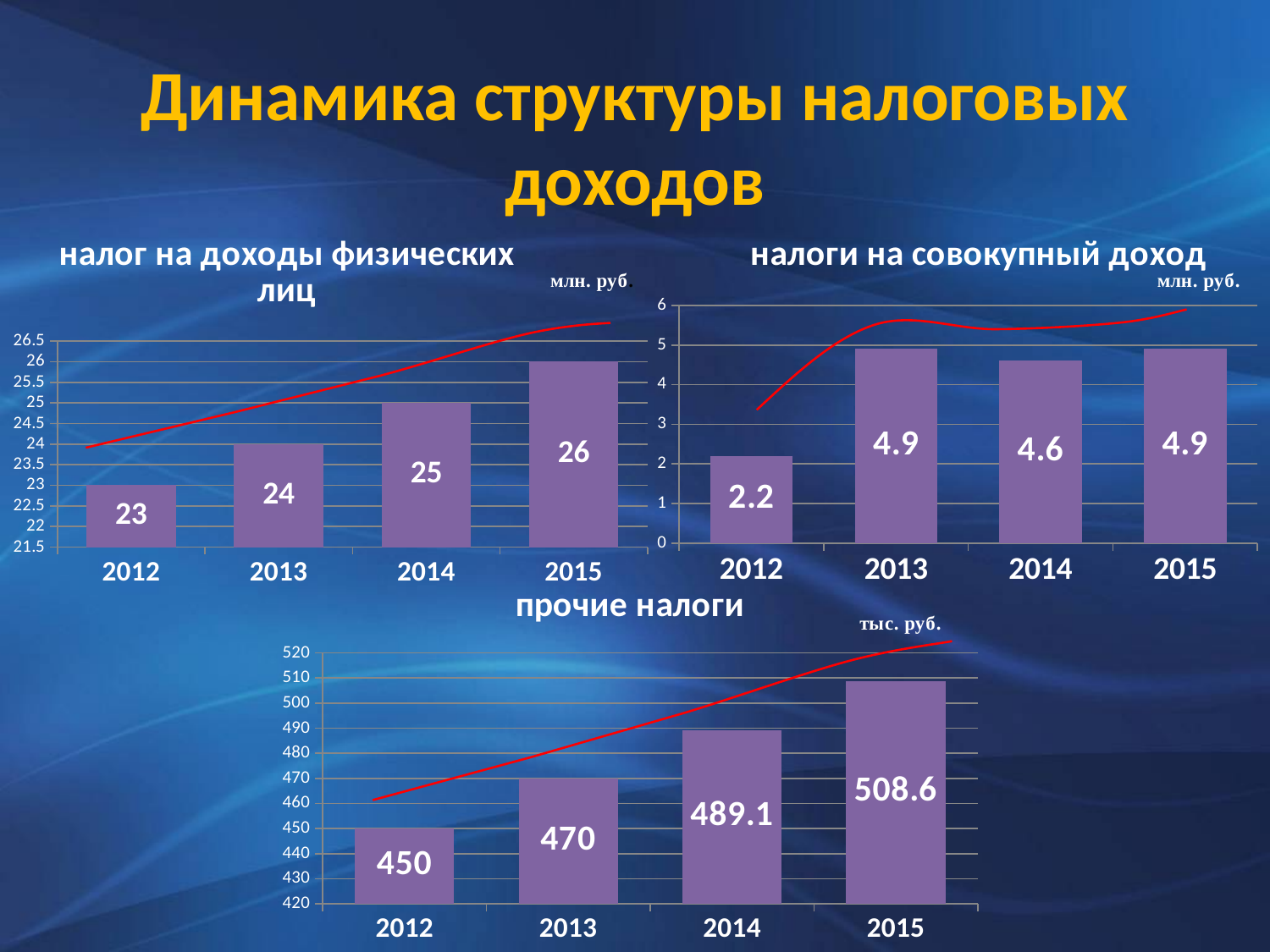
In the chart 'прочие налоги', what is the difference between the values for 2014 and 2013? 19.1 In the chart 'налог на доходы физических лиц', what is the difference between the values for 2015 and 2012? 3 In the chart 'налог на доходы физических лиц', which year has the lowest value? 2012 In the chart 'налоги на совокупный доход', what is the value for 2014? 4.6 In the chart 'налоги на совокупный доход', which is larger, the value for 2013 or the value for 2014? 2013 In the chart 'прочие налоги', what is the value for 2015? 508.6 In the chart 'прочие налоги', which year has the highest value? 2015 In the chart 'налоги на совокупный доход', what is the value for 2012? 2.2 In the chart 'налоги на совокупный доход', how many years are shown on the x axis? 4 In the chart 'налог на доходы физических лиц', do the values rise or fall from 2012 to 2015? rise In the chart 'налог на доходы физических лиц', what is the value for 2014? 25 What kind of chart is 'прочие налоги'? bar chart